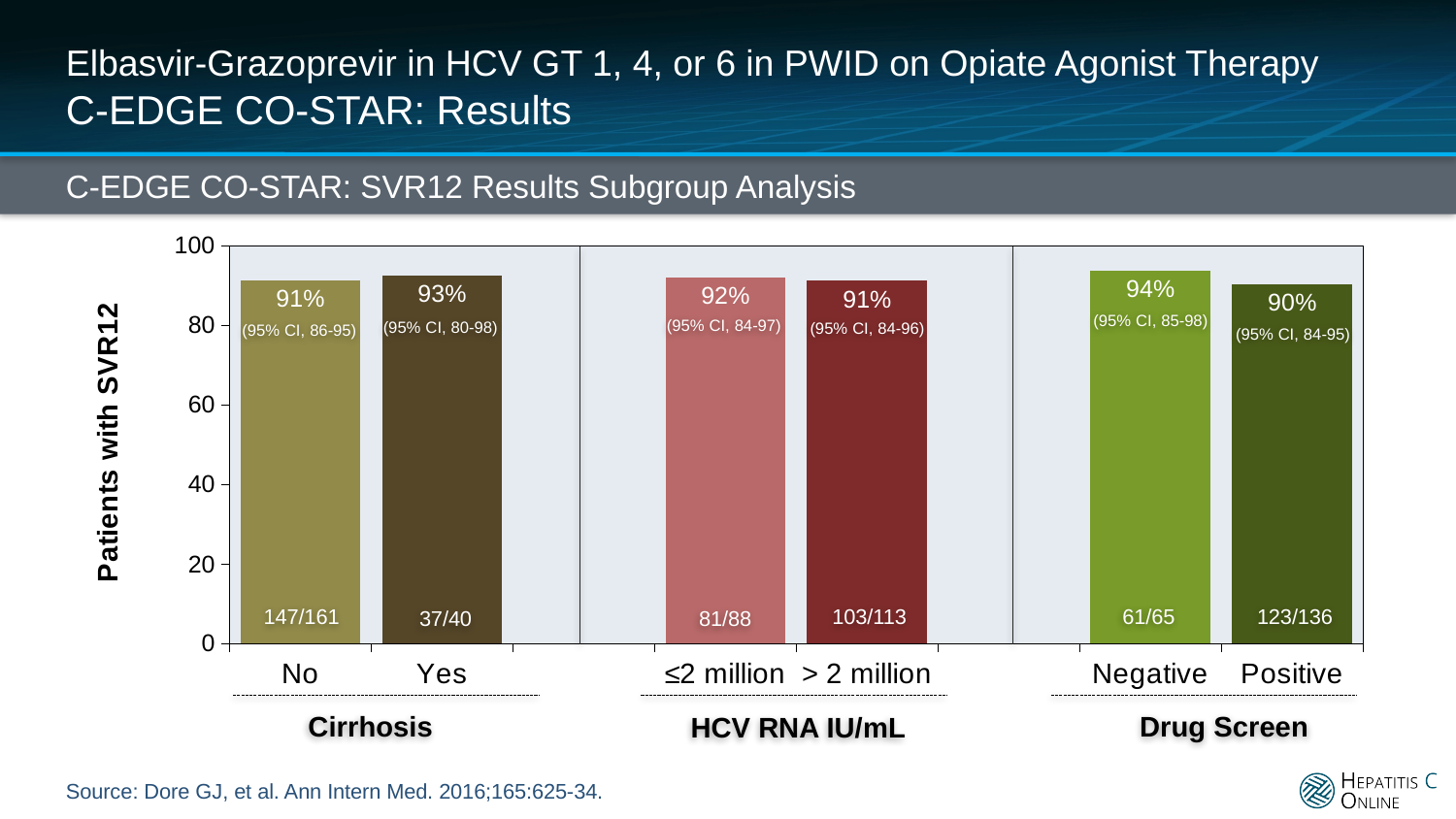
Which subgroup has the lowest SVR12 rate? Positive (Drug Screen) Which has a higher SVR12 rate: patients with cirrhosis or patients without cirrhosis? Patients with cirrhosis (Yes) What is the 95% confidence interval shown for the HCV RNA ≤2 million IU/mL group? 95% CI, 84-97 What type of chart is used to display the SVR12 subgroup results? Bar chart What is the SVR12 rate for patients with HCV RNA > 2 million IU/mL? 91% What is the SVR12 rate for patients with a positive drug screen? 90% What is the SVR12 rate for patients with cirrhosis (Cirrhosis: Yes)? 93% What is the difference in SVR12 rate between the negative and positive drug screen groups? 4% How many patients achieved SVR12 out of the total in the negative drug screen group, as labeled on the bar? 61/65 What is the SVR12 rate for patients without cirrhosis (Cirrhosis: No)? 91% Which subgroup has the highest SVR12 rate? Negative (Drug Screen) How many bars are shown in the chart? 6